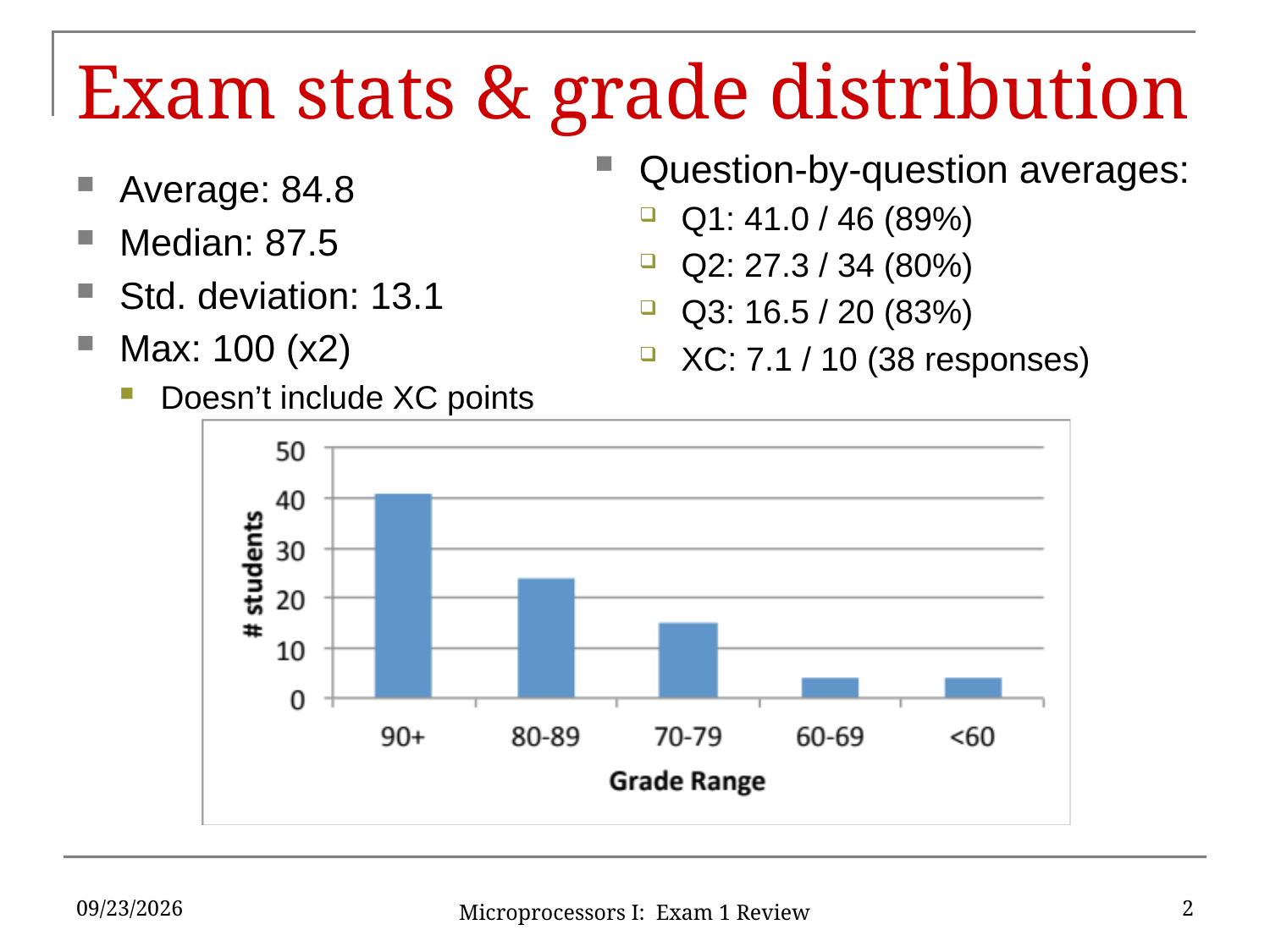
What kind of chart is shown on the slide? bar chart How many grade range categories are shown on the x axis of the chart? 5 Which has more students, the 80-89 grade range or the 70-79 grade range? 80-89 Which grade range has the highest number of students? 90+ Is the number of students in the 70-79 grade range greater or less than 10? greater Do the bar heights generally rise or fall moving from 90+ to <60 along the x axis? fall Is the number of students in the 60-69 grade range greater or less than 10? less Is the number of students in the 90+ grade range greater or less than 30? greater What is the label of the y axis of the chart? # students